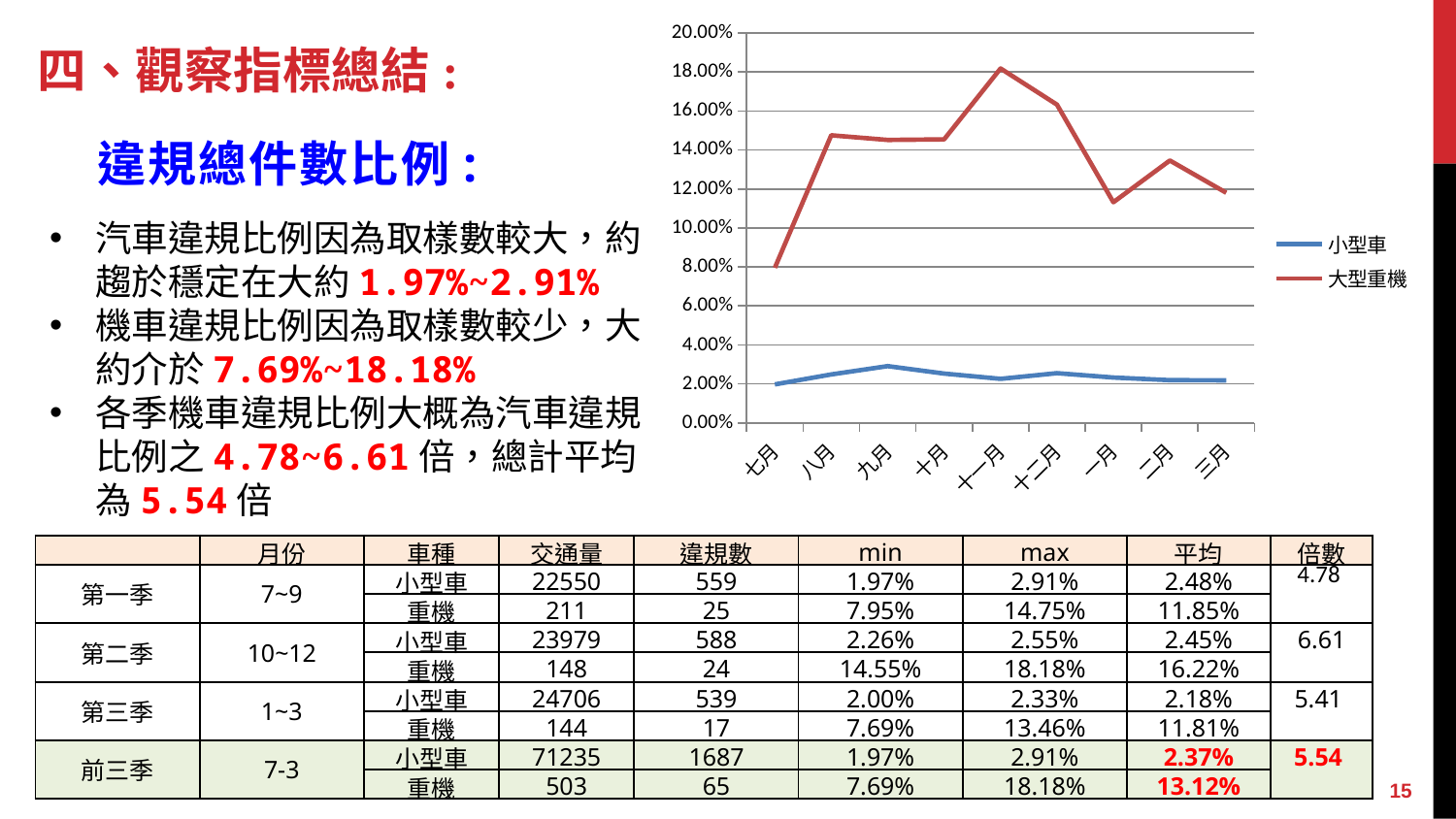
Is the value for 大型重機 in 七月 greater or less than 10.00%? less How many series does the chart legend list? 2 How many months are plotted along the x axis of the chart? 9 In which month does the 小型車 line reach its highest value? 九月 In which month is the 大型重機 line at its lowest value? 七月 Which series has the larger value in 一月, 小型車 or 大型重機? 大型重機 Does the 大型重機 line rise or fall from 十一月 to 一月? fall Which colour is used for the 大型重機 line in the chart? red In which month does the 大型重機 line reach its highest value? 十一月 Is the value for 大型重機 in 十一月 greater or less than 16.00%? greater What kind of chart is shown on the slide? line chart Is the value for 小型車 in 九月 greater or less than 4.00%? less